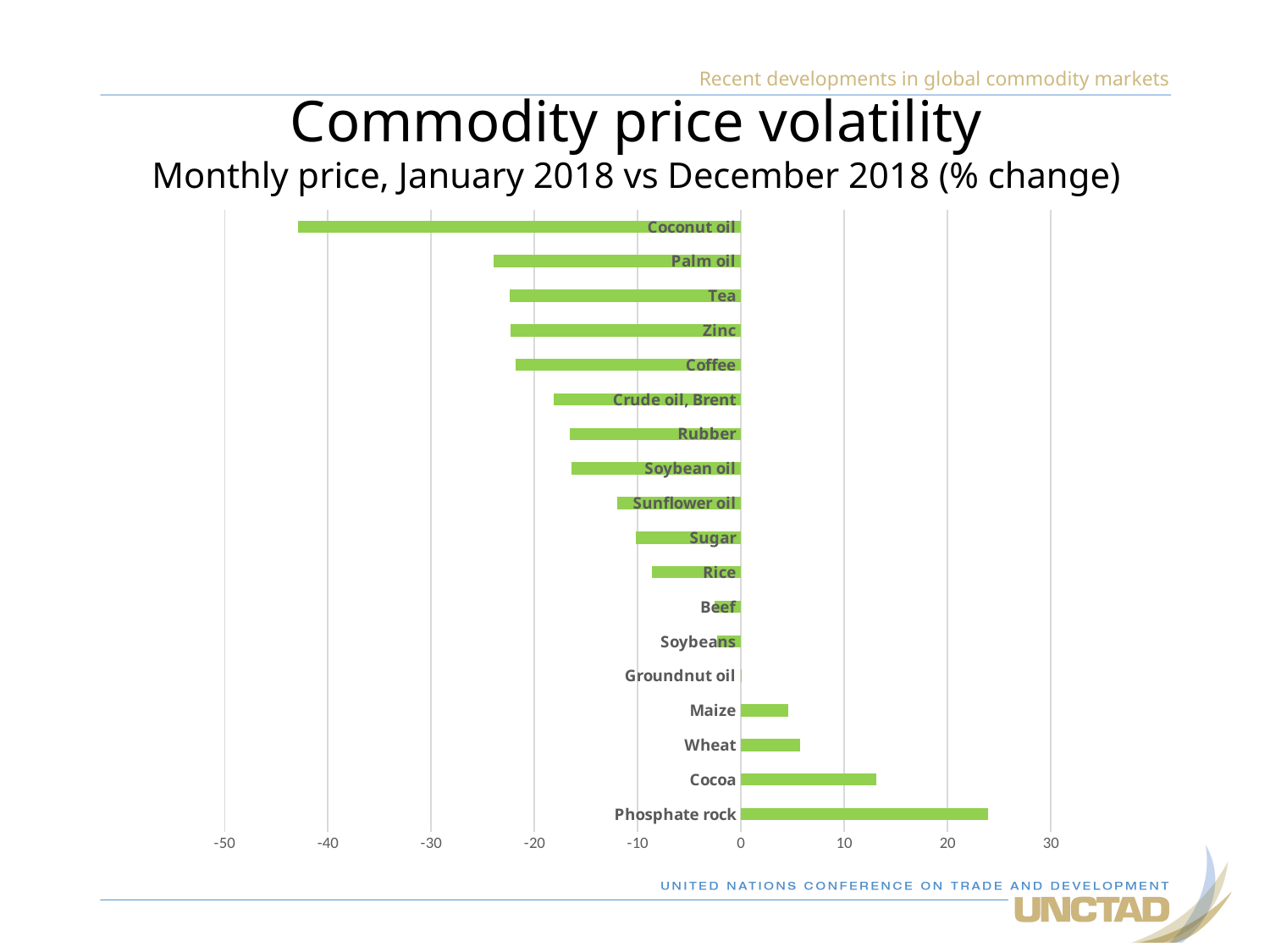
Is the value for Cocoa greater or less than 10? greater How many commodities are plotted in the chart? 18 Which has the larger value, Coconut oil or Palm oil? Palm oil Is the value for Phosphate rock greater or less than 20? greater What kind of chart is shown on the slide? bar chart Which commodity has the lowest value in the chart? Coconut oil Which has the larger value, Phosphate rock or Cocoa? Phosphate rock Is the value for Palm oil greater or less than -20? less Which commodity has the highest value in the chart? Phosphate rock What is the subtitle of the chart describing the period compared? Monthly price, January 2018 vs December 2018 (% change)